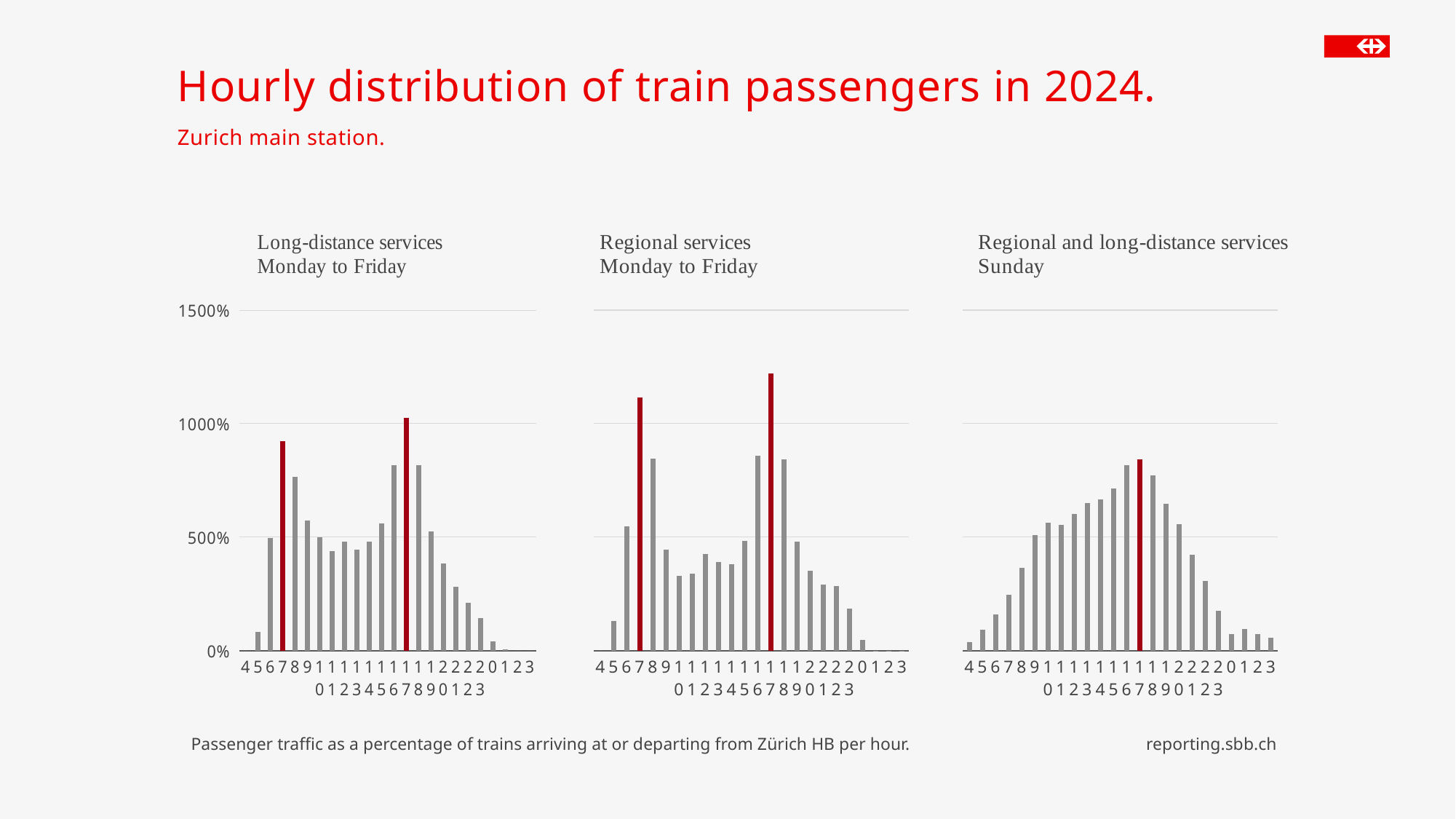
In the 'Long-distance services Monday to Friday' chart, which hours are highlighted with red bars? 7 and 17 In the 'Regional services Monday to Friday' chart, is the value for hour 17 greater or less than 1000%? greater In the 'Regional services Monday to Friday' chart, how many hourly bars are plotted? 24 In the 'Long-distance services Monday to Friday' chart, which hour has the highest value? 17 In the 'Regional and long-distance services Sunday' chart, is the value for hour 17 greater or less than 1000%? less In the 'Regional services Monday to Friday' chart, which is larger, the value for hour 7 or the value for hour 16? hour 7 In the 'Regional services Monday to Friday' chart, which hour has the highest value? 17 In the 'Regional and long-distance services Sunday' chart, do the values rise or fall from hour 4 to hour 17? rise In the 'Regional and long-distance services Sunday' chart, is the value for hour 4 greater or less than 500%? less What kind of chart is the 'Long-distance services Monday to Friday' chart? bar chart How many charts are shown on the slide? 3